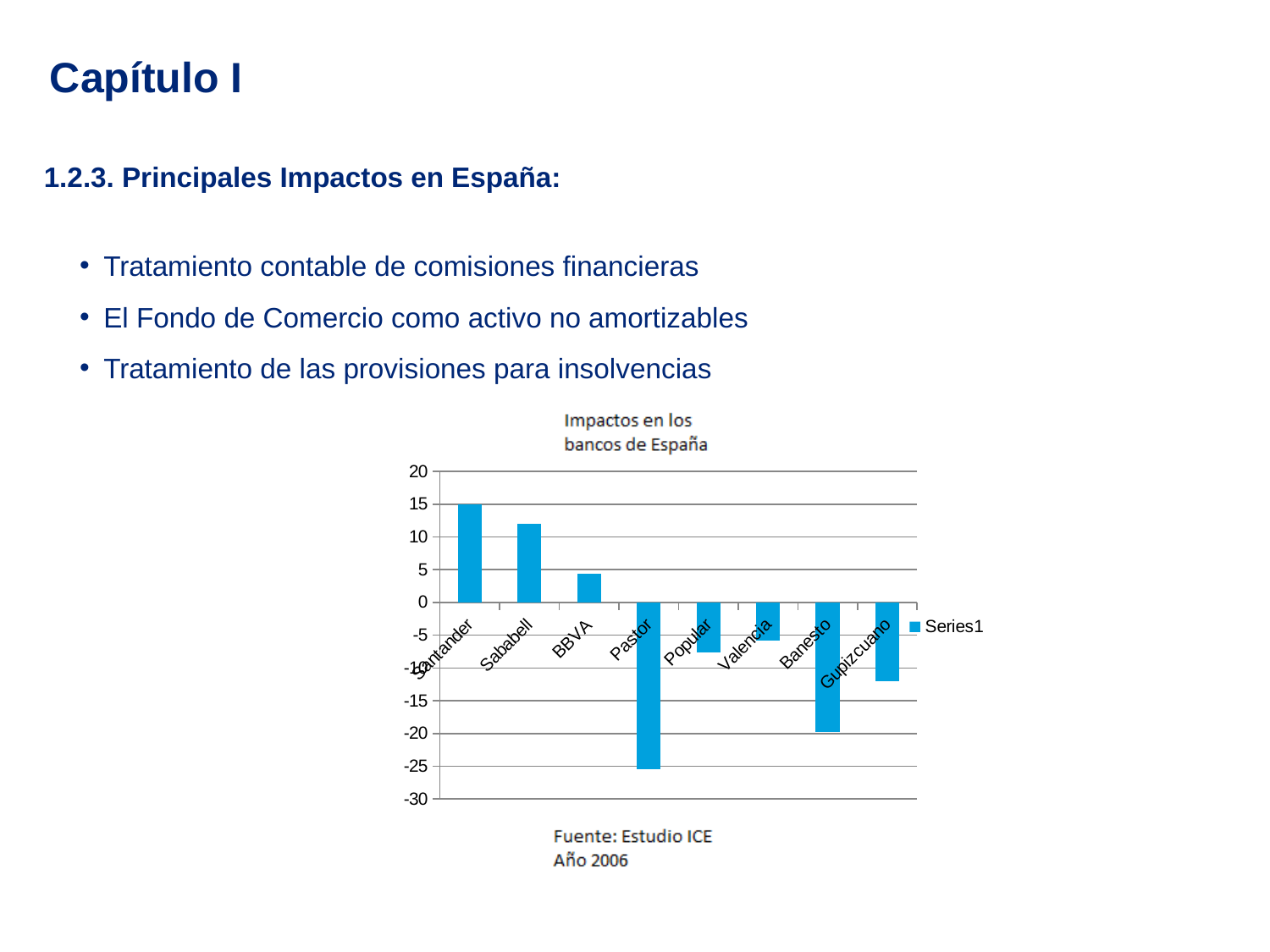
What kind of chart is shown on the slide? bar chart What is the value for Santander? 15 What is the title of the chart? Impactos en los bancos de España Is the value for BBVA greater or less than 5? less How many banks (categories) are plotted in the chart? 8 How many series does the chart legend list? 1 Which bank has the highest value in the chart? Santander Which is larger, the value for Santander or the value for Sabadell? Santander Which bank has the lowest value in the chart? Pastor Is the value for Pastor greater or less than -20? less Is the value for Sabadell greater or less than 10? greater